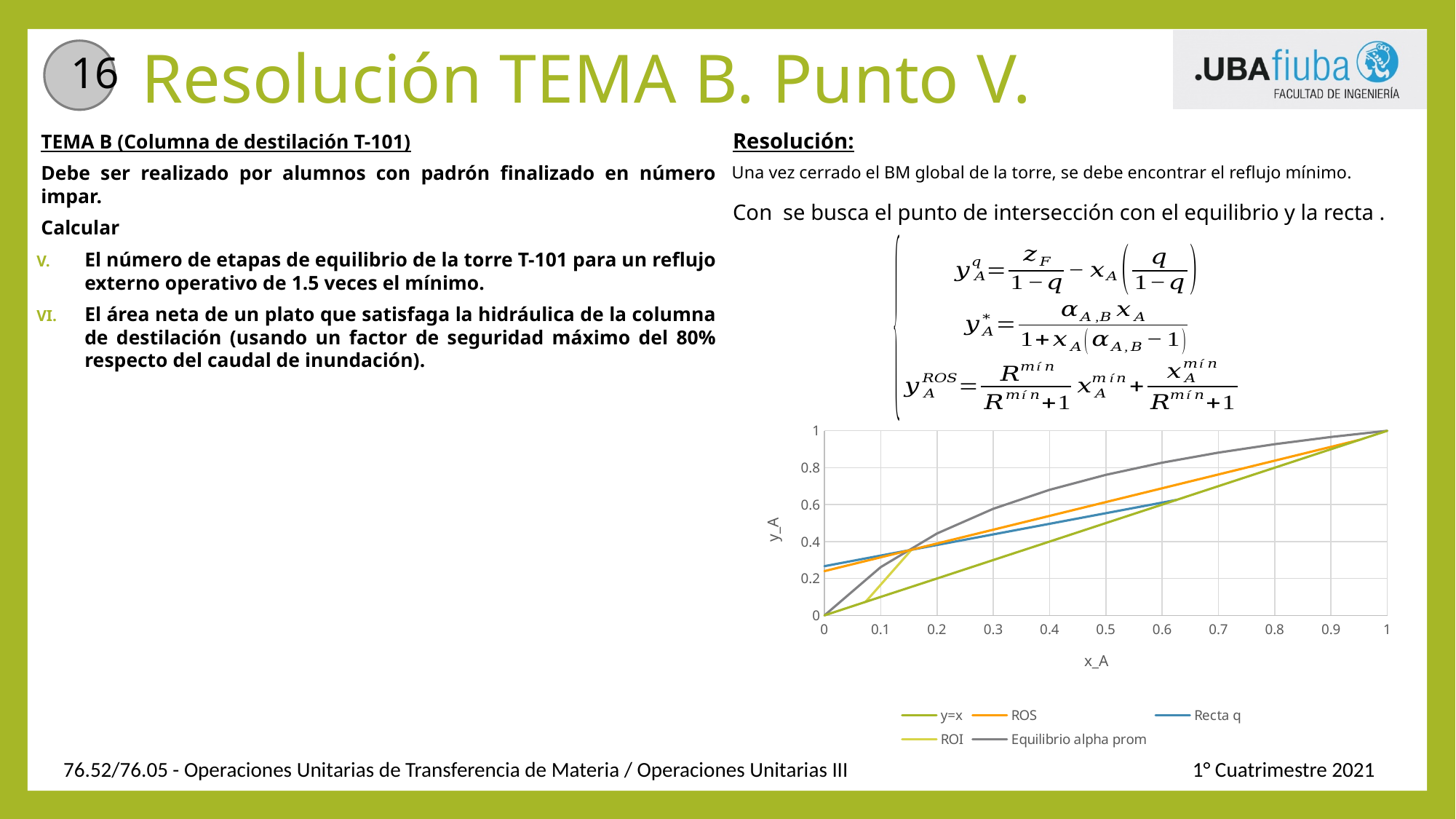
Is the value of the ROS line at x_A = 0 greater or less than 0.4? less At x_A = 0.8, which series has the higher y_A value: ROS or y=x? ROS Is the value of the Recta q line at x_A = 0 greater or less than 0.2? greater At x_A = 0.5, which series has the higher y_A value: Equilibrio alpha prom or ROS? Equilibrio alpha prom Is the value of the Equilibrio alpha prom curve at x_A = 0.5 greater or less than 0.6? greater Does the Equilibrio alpha prom curve rise or fall as x_A increases from 0 to 1? rise What is the label of the horizontal axis of the chart? x_A What is the label of the vertical axis of the chart? y_A How many series does the chart legend list? 5 What is the y_A value of the y=x line at x_A = 1? 1 What kind of chart is shown on the slide? line chart